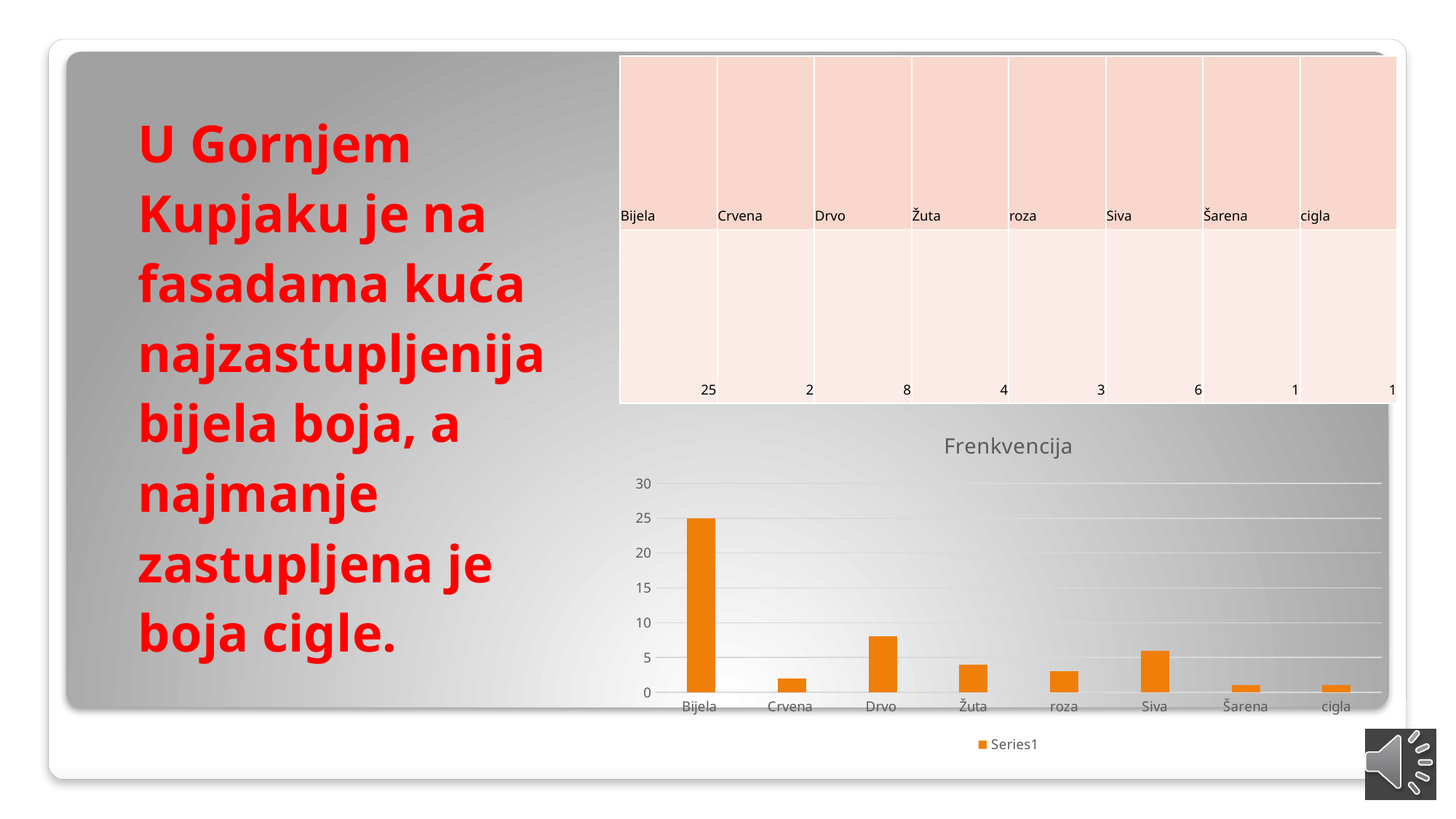
Which category has the highest value in the chart? Bijela What is the value for Bijela? 25 What is the value for Drvo? 8 How many categories are shown on the x axis of the chart? 8 Which is larger, the value for Siva or the value for Žuta? Siva What kind of chart is shown under the title 'Frenkvencija'? bar chart Is the value for Bijela greater or less than 20? greater Is the value for Crvena greater or less than 5? less What is the title of the chart? Frenkvencija What is the difference between the values for Bijela and Drvo? 17 How many series does the legend of the chart list? 1 What is the value for Siva? 6